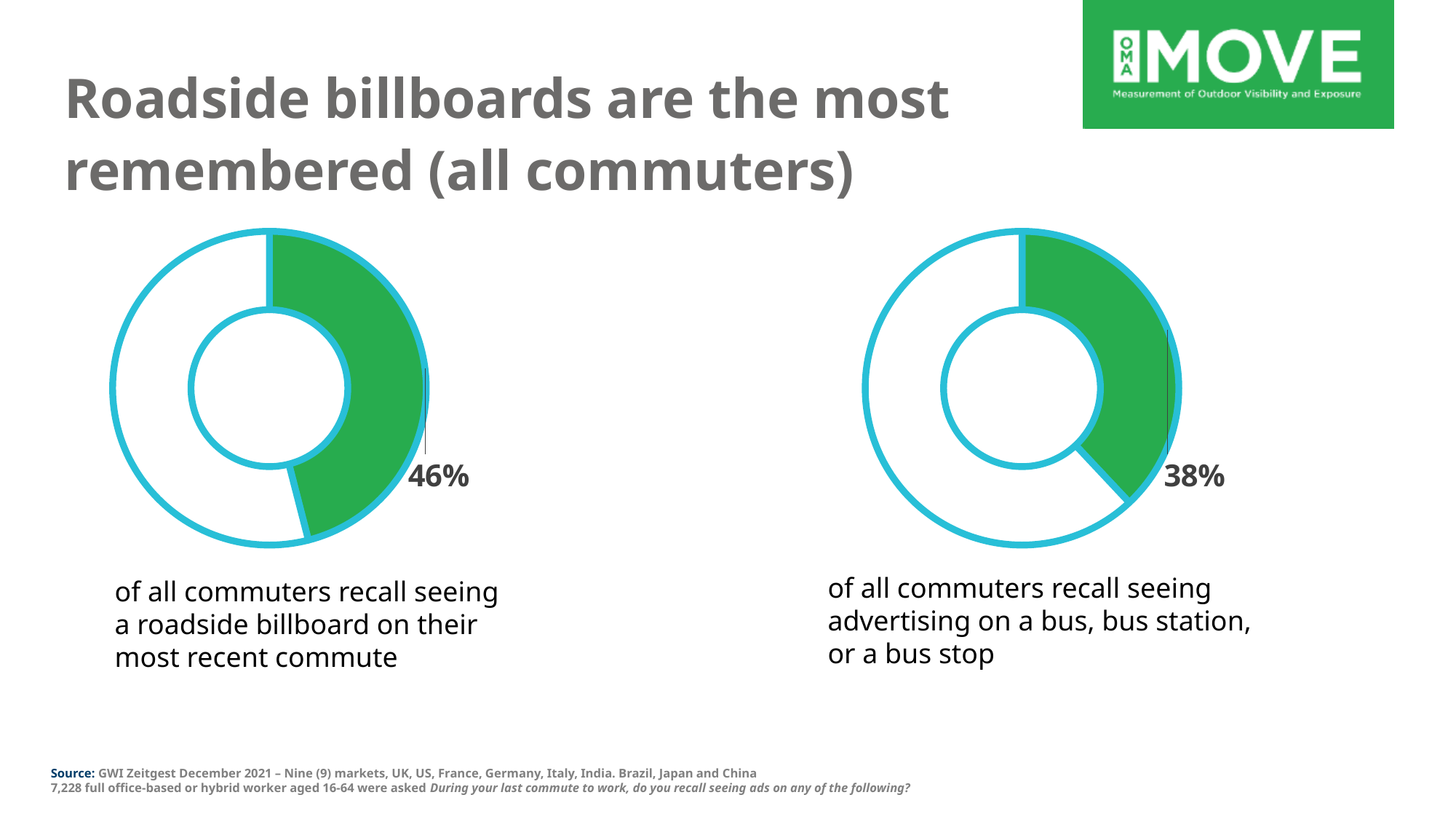
What kind of chart is used on the left side of the slide? Donut chart On the left chart, what share of the donut is not filled green (the remainder after the 46% slice)? 54% On the left chart, is the green slice for roadside billboard recall greater or less than 50% of the donut? less On the right chart, is the green slice for bus advertising recall greater or less than 25% of the donut? greater What is the title of the slide containing the two donut charts? Roadside billboards are the most remembered (all commuters) What is the difference in percentage points between the roadside billboard recall (left chart) and the bus advertising recall (right chart)? 8 percentage points What kind of chart is used on the right side of the slide? Donut chart What colour is the highlighted slice in both donut charts? Green On the left chart, what percentage of all commuters recall seeing a roadside billboard on their most recent commute? 46% On the right chart, what percentage of all commuters recall seeing advertising on a bus, bus station, or a bus stop? 38% How many donut charts are shown on the slide? 2 Which is larger: the share of commuters recalling a roadside billboard (left chart) or the share recalling bus advertising (right chart)? Roadside billboard (46%)